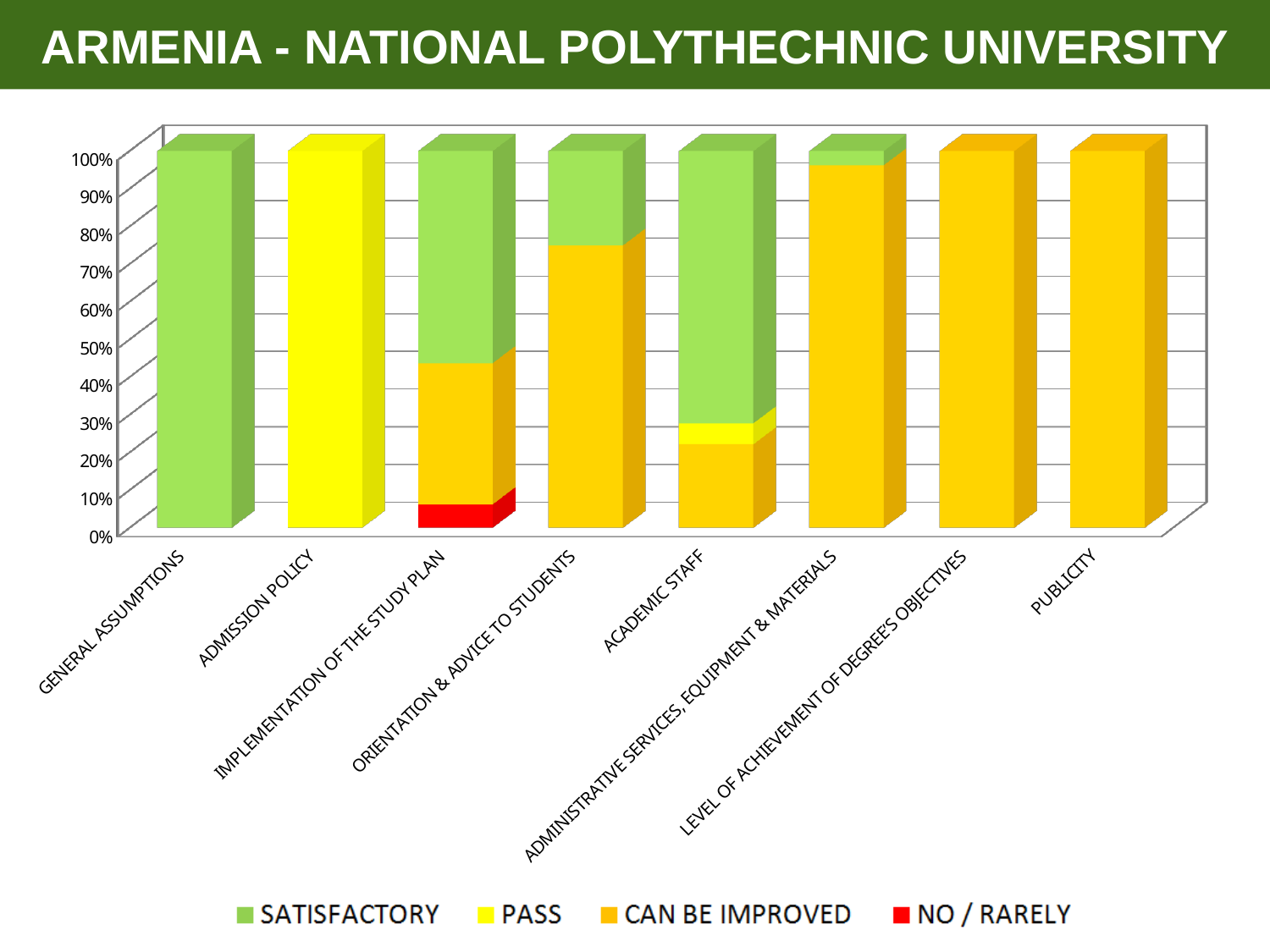
How many categories are shown along the x axis of the chart? 8 What colour represents NO / RARELY in the legend? Red Is the SATISFACTORY share for ORIENTATION & ADVICE TO STUDENTS greater or less than 50%? less What kind of chart is shown on the slide? Stacked bar chart Is the CAN BE IMPROVED share for ADMINISTRATIVE SERVICES, EQUIPMENT & MATERIALS greater or less than 80%? greater What is the PASS value for ADMISSION POLICY? 100% What is the CAN BE IMPROVED value for PUBLICITY? 100% How many series does the legend list? 4 Is the SATISFACTORY share for ACADEMIC STAFF greater or less than 50%? greater Which has the larger SATISFACTORY share, ACADEMIC STAFF or ORIENTATION & ADVICE TO STUDENTS? ACADEMIC STAFF What is the SATISFACTORY value for GENERAL ASSUMPTIONS? 100% Which category is the only one with a NO / RARELY segment? IMPLEMENTATION OF THE STUDY PLAN